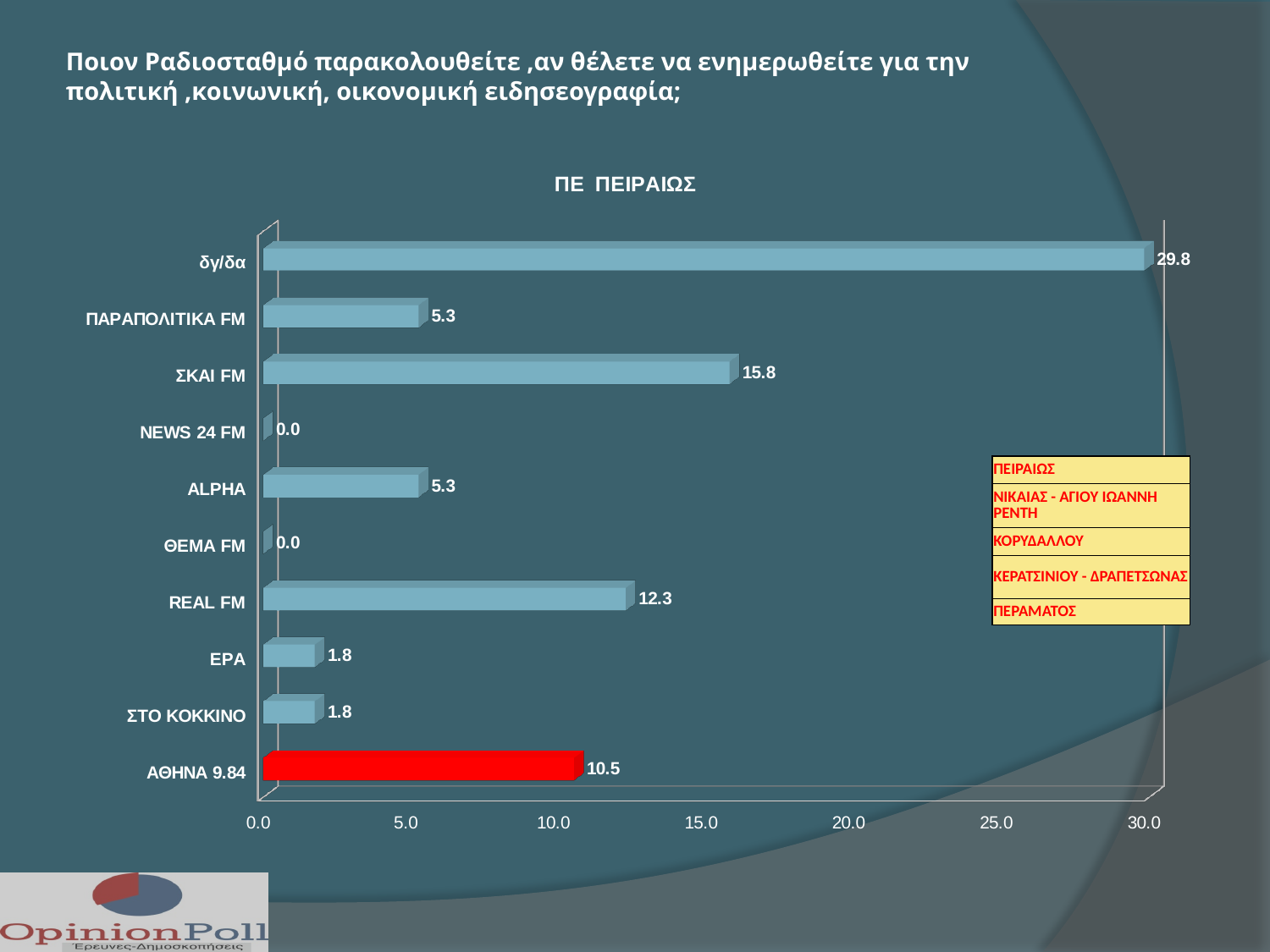
What is the value for ΕΡΑ? 1.8 What is the difference between the values for ΣΚΑΙ FM and REAL FM? 3.5 What is the value for REAL FM? 12.3 Which category has the highest value? δγ/δα Which bar is coloured red? ΑΘΗΝΑ 9.84 What is the title of the chart? ΠΕ ΠΕΙΡΑΙΩΣ How many categories are shown on the chart? 10 Which is larger, the value for ΠΑΡΑΠΟΛΙΤΙΚΑ FM or the value for ΑΘΗΝΑ 9.84? ΑΘΗΝΑ 9.84 What is the value for ΣΚΑΙ FM? 15.8 Is the value for δγ/δα greater or less than 25.0? greater What is the value for ΑΘΗΝΑ 9.84? 10.5 What kind of chart is shown on the slide? bar chart